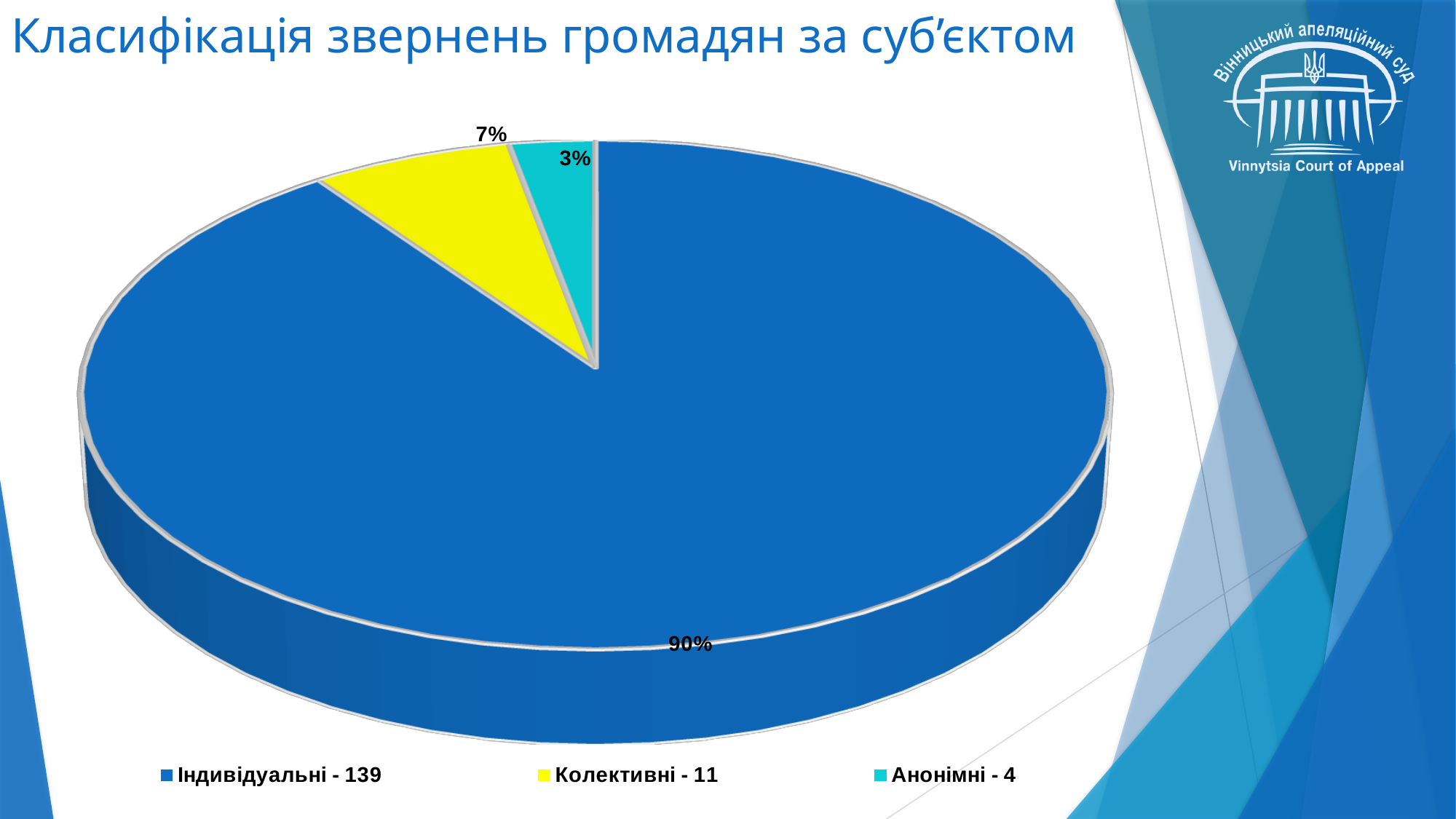
What is the difference between the number of Колективні and Анонімні appeals? 7 What percentage share does the Анонімні slice have? 3% How many appeals are listed for Колективні in the legend? 11 How many appeals are listed for Індивідуальні in the legend? 139 How many categories does the pie chart show? 3 What colour is the Колективні slice? yellow How many appeals are listed for Анонімні in the legend? 4 What percentage share does the Індивідуальні slice have? 90% Which category has the smallest slice of the pie? Анонімні What kind of chart is shown on the slide? pie chart Which category has the largest slice of the pie? Індивідуальні What percentage share does the Колективні slice have? 7%